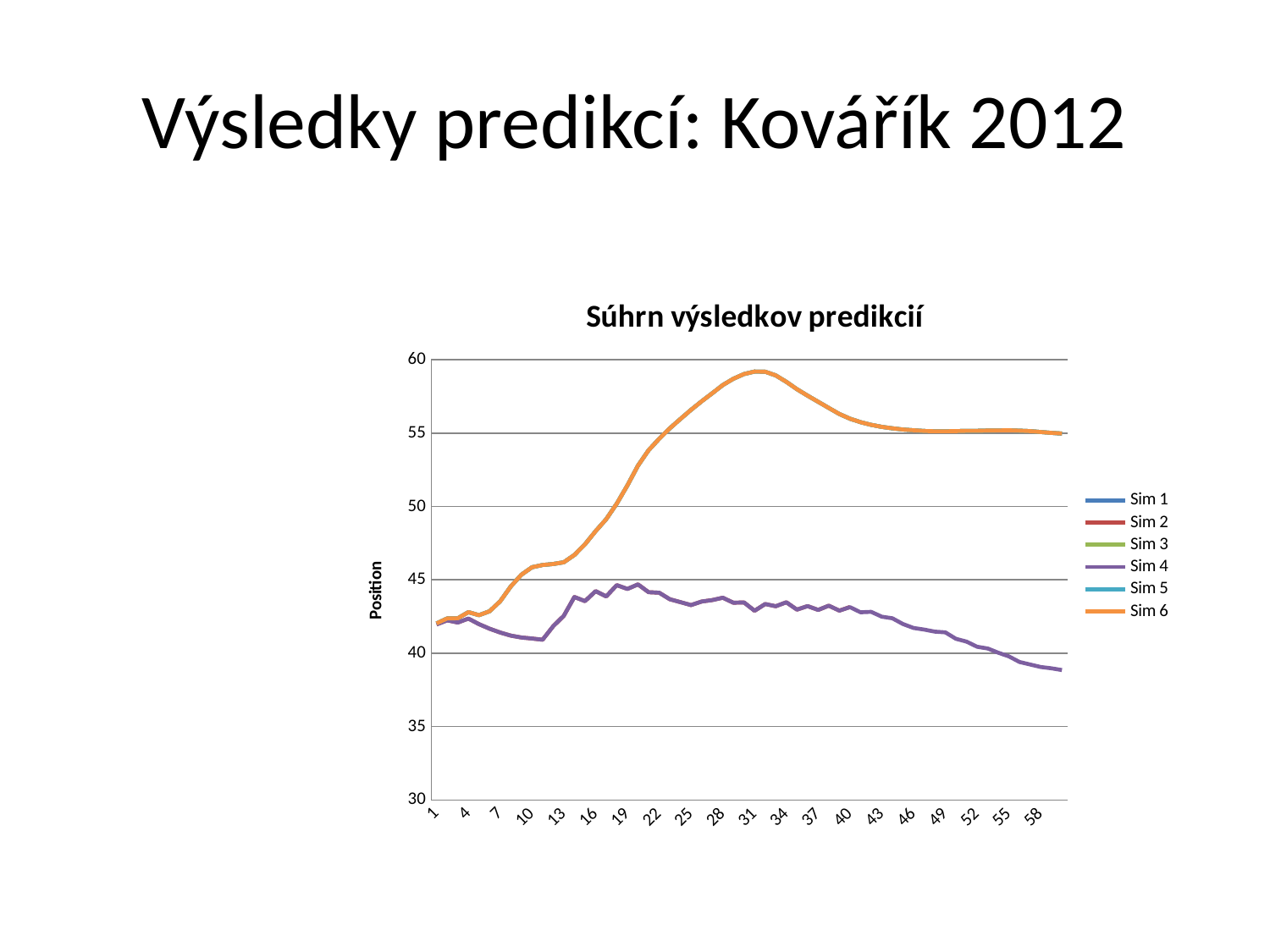
Is the value of Sim 4 at x = 58 greater or less than 40? less Is the value of Sim 6 at x = 31 greater or less than 55? greater What is the label of the vertical axis? Position What kind of chart is shown on the slide? line chart Does the Sim 4 line rise or fall between x = 43 and x = 58? fall Is the value of Sim 4 at x = 10 greater or less than 45? less Does the Sim 6 line rise or fall between x = 13 and x = 31? rise How many series does the legend list? 6 What is the title of the chart? Súhrn výsledkov predikcií At x = 31, which series has the larger value, Sim 6 or Sim 4? Sim 6